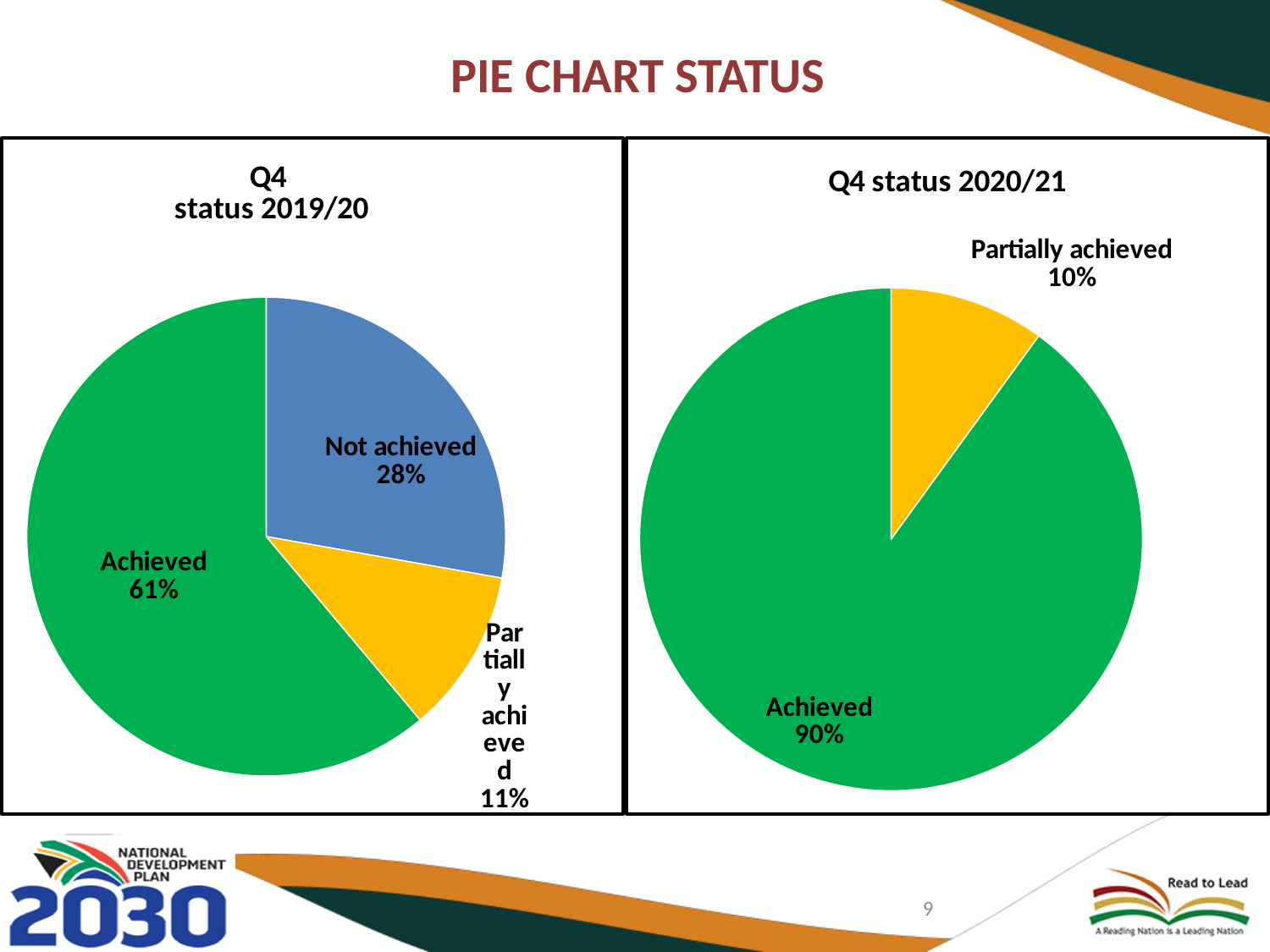
In the Q4 status 2019/20 chart, what percentage is labelled Not achieved? 28% Which chart has the larger Achieved share, Q4 status 2019/20 or Q4 status 2020/21? Q4 status 2020/21 How many slices does the Q4 status 2019/20 chart have? 3 In the Q4 status 2020/21 chart, what is the difference between the Achieved and Partially achieved percentages? 80% In the Q4 status 2019/20 chart, what percentage is labelled Achieved? 61% In the Q4 status 2020/21 chart, what percentage is labelled Partially achieved? 10% In the Q4 status 2019/20 chart, which category has the largest slice? Achieved What type of chart is the Q4 status 2020/21 chart? Pie chart In the Q4 status 2019/20 chart, which category has the smallest slice? Partially achieved In the Q4 status 2020/21 chart, what percentage is labelled Achieved? 90% In the Q4 status 2019/20 chart, what is the difference between the Not achieved and Partially achieved percentages? 17% In the Q4 status 2019/20 chart, what percentage is labelled Partially achieved? 11%